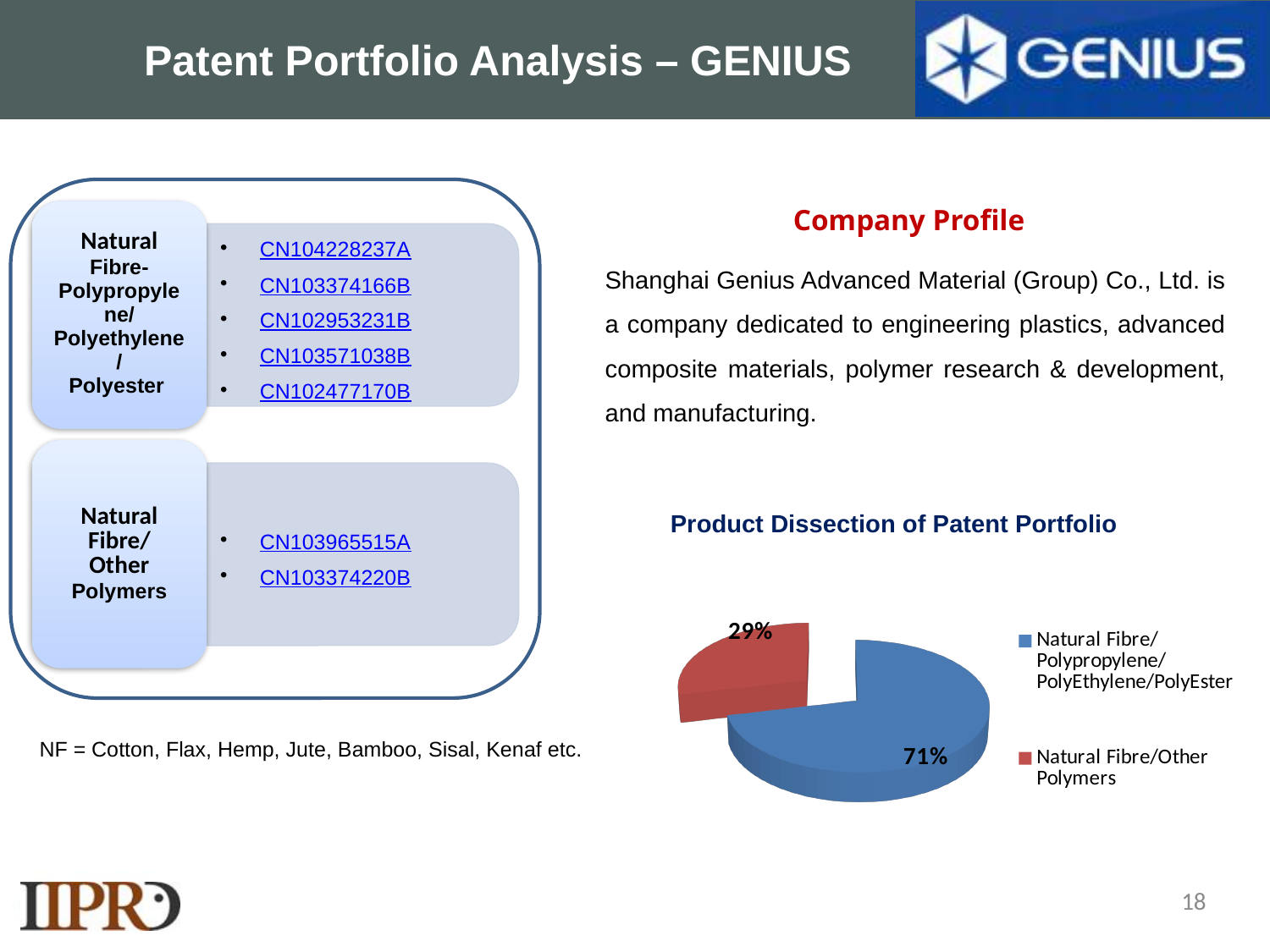
What is the title of the pie chart? Product Dissection of Patent Portfolio Which is larger in the pie chart: Natural Fibre/Other Polymers or Natural Fibre/Polypropylene/PolyEthylene/PolyEster? Natural Fibre/Polypropylene/PolyEthylene/PolyEster Which category has the largest slice in the pie chart? Natural Fibre/Polypropylene/PolyEthylene/PolyEster What kind of chart is shown under 'Product Dissection of Patent Portfolio'? pie chart What colour is the Natural Fibre/Other Polymers slice in the pie chart? red Which category has the smallest slice in the pie chart? Natural Fibre/Other Polymers How many slices does the pie chart have? 2 What share of the pie chart does Natural Fibre/Polypropylene/PolyEthylene/PolyEster hold? 71% What is the difference in percentage points between the Natural Fibre/Polypropylene/PolyEthylene/PolyEster slice and the Natural Fibre/Other Polymers slice? 42 What share of the pie chart does Natural Fibre/Other Polymers hold? 29% How many entries does the pie chart legend list? 2